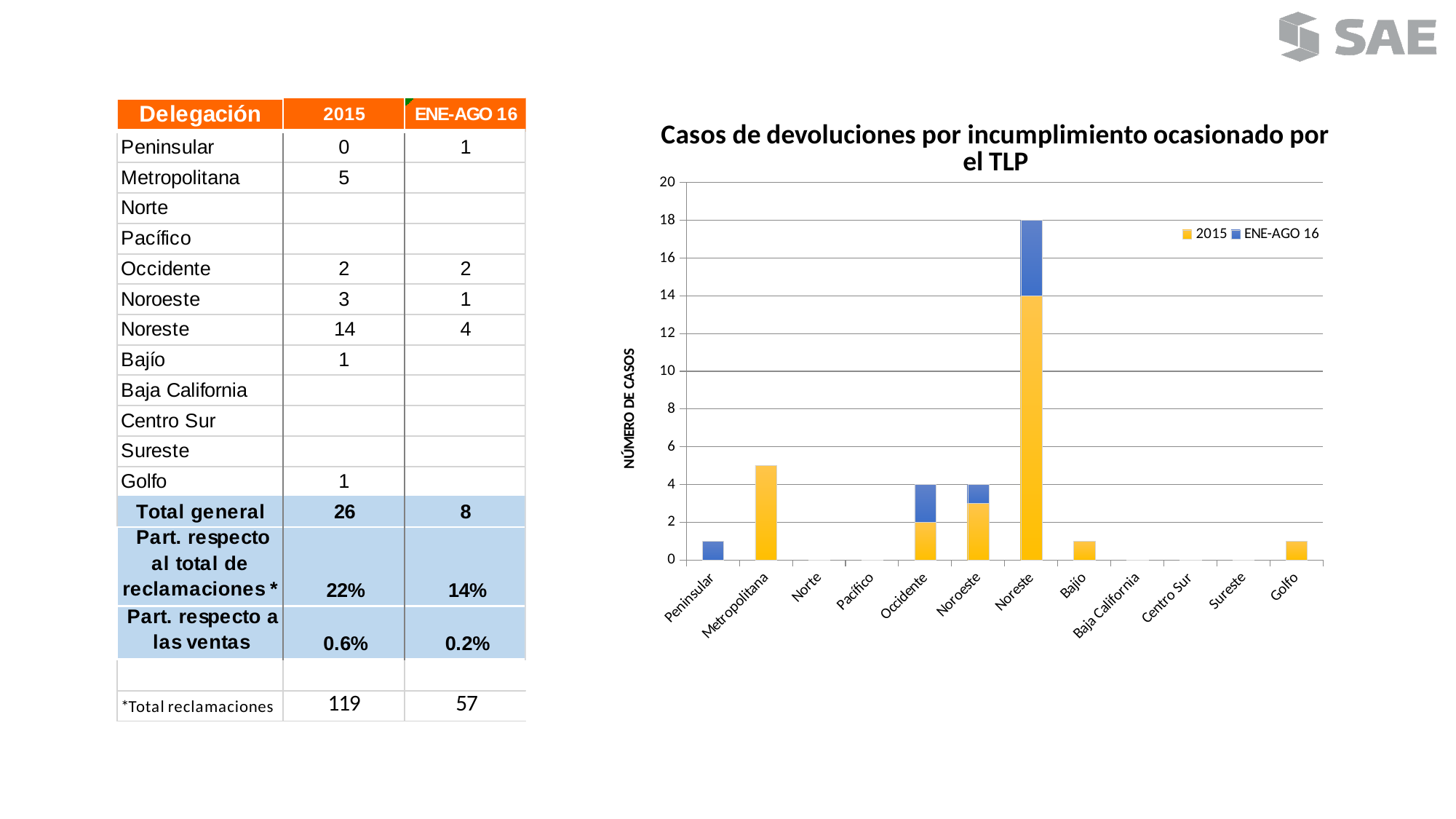
Which delegación has the tallest bar in the chart? Noreste What kind of chart is shown on the slide? Stacked bar chart What is the difference between the 2015 value and the ENE-AGO 16 value for Noreste? 10 What is the title of the chart's vertical axis? NÚMERO DE CASOS How many series does the chart legend list? 2 What is the total of the stacked bar for Noroeste? 4 How many delegaciones (categories) are shown on the x axis of the chart? 12 What is the total height of the stacked bar for Noreste? 18 Is the value for Metropolitana greater or less than 4? greater Which is larger, the bar for Metropolitana or the bar for Bajío? Metropolitana What is the 2015 value for Noreste in the chart? 14 What is the 2015 value for Occidente in the chart? 2